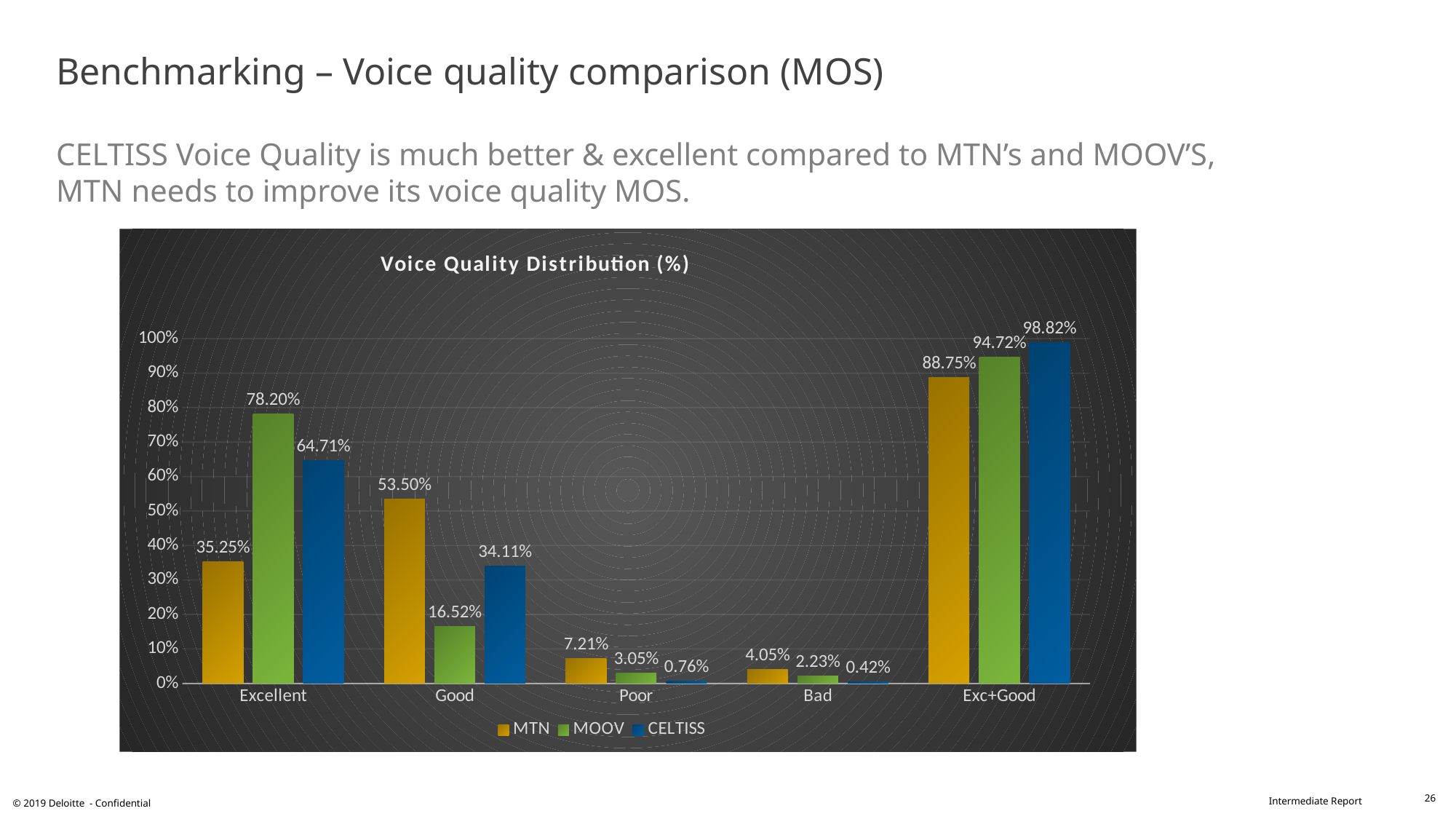
Which series has the lowest value in the Bad category? CELTISS What is the difference between the MOOV and MTN values for Exc+Good? 5.97% Which is larger in the Excellent category, the MTN value or the CELTISS value? CELTISS What kind of chart is shown on the slide? Bar chart Which series has the highest value in the Good category? MTN How many categories are shown on the x axis? 5 How many series does the legend list? 3 What is the MOOV value for the Excellent category? 78.20% What is the CELTISS value for the Good category? 34.11% What is the title of the chart? Voice Quality Distribution (%) What is the MTN value for the Poor category? 7.21% What is the CELTISS value for Exc+Good? 98.82%